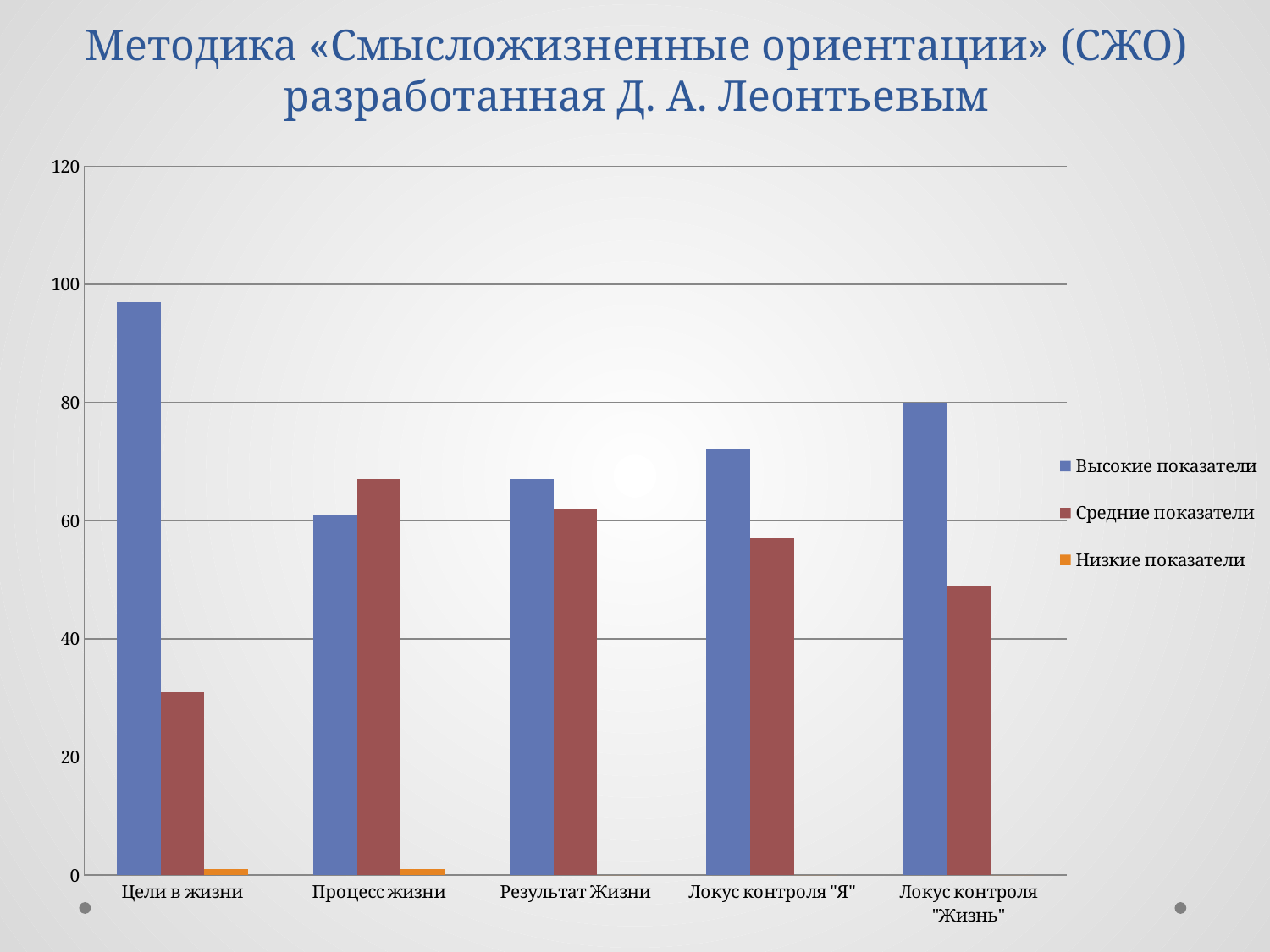
Is the value of Средние показатели for Цели в жизни greater or less than 40? less How many series does the legend list? 3 How many categories are shown along the x axis? 5 Which series is shown in orange in the legend? Низкие показатели Is the value of Высокие показатели for Цели в жизни greater or less than 80? greater Which category has the highest value for Средние показатели? Процесс жизни What kind of chart is shown on the slide? bar chart For Процесс жизни, which is larger: Высокие показатели or Средние показатели? Средние показатели Do the values of Средние показатели rise or fall from Процесс жизни to Локус контроля "Жизнь"? fall Which category has the lowest value for Средние показатели? Цели в жизни Is the value of Средние показатели for Локус контроля "Жизнь" greater or less than 60? less Which category has the highest value for Высокие показатели? Цели в жизни